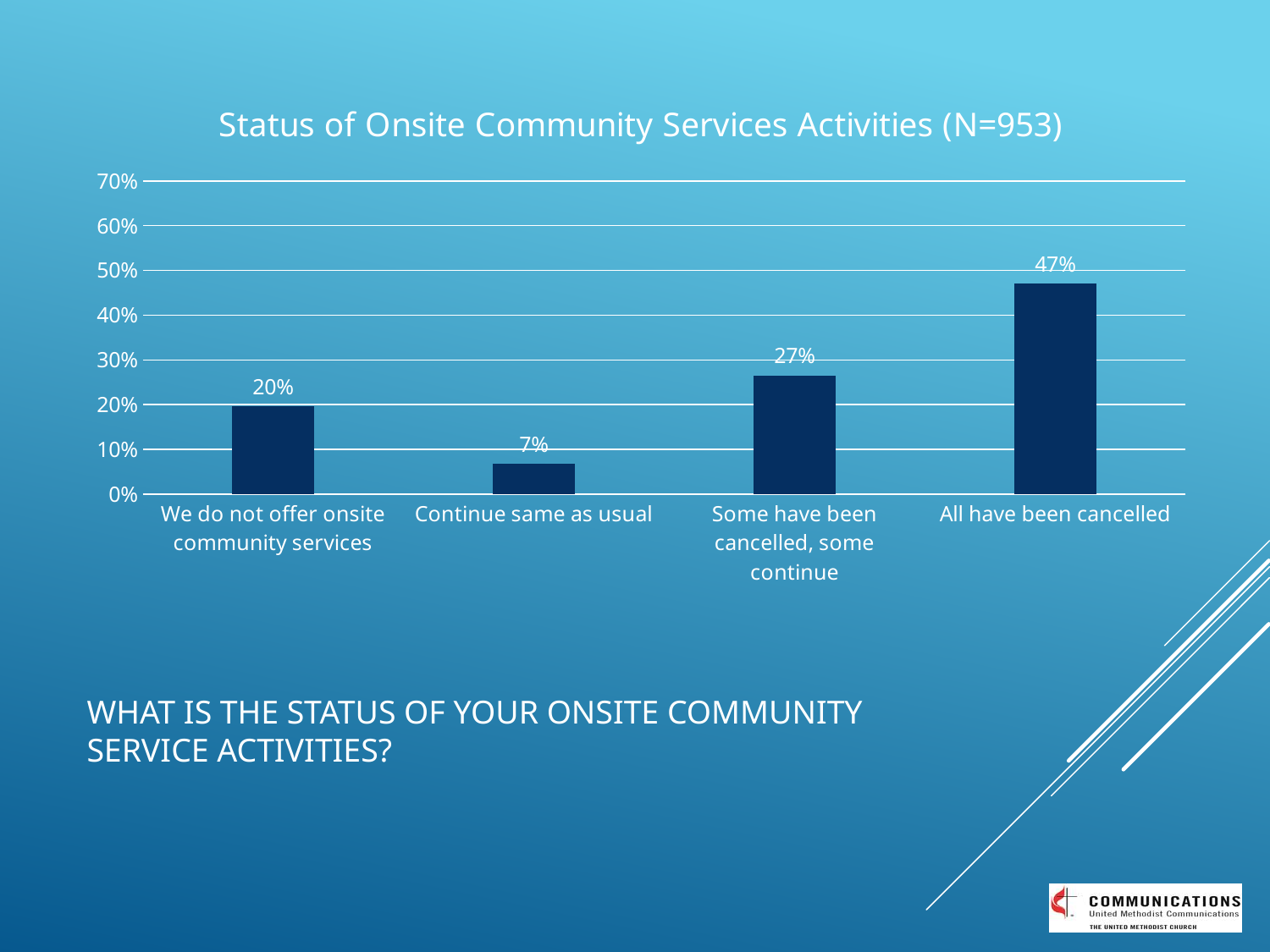
What is the value for "We do not offer onsite community services"? 20% What is the value for "All have been cancelled"? 47% Which category has the highest value? All have been cancelled How many categories are shown in the chart? 4 What is the difference between "We do not offer onsite community services" and "Continue same as usual"? 13% What is the difference between "All have been cancelled" and "Some have been cancelled, some continue"? 20% Which category has the lowest value? Continue same as usual What is the value for "Continue same as usual"? 7% What kind of chart is shown on the slide? Bar chart Which is larger: "Some have been cancelled, some continue" or "We do not offer onsite community services"? Some have been cancelled, some continue What is the title of the chart? Status of Onsite Community Services Activities (N=953) What is the value for "Some have been cancelled, some continue"? 27%